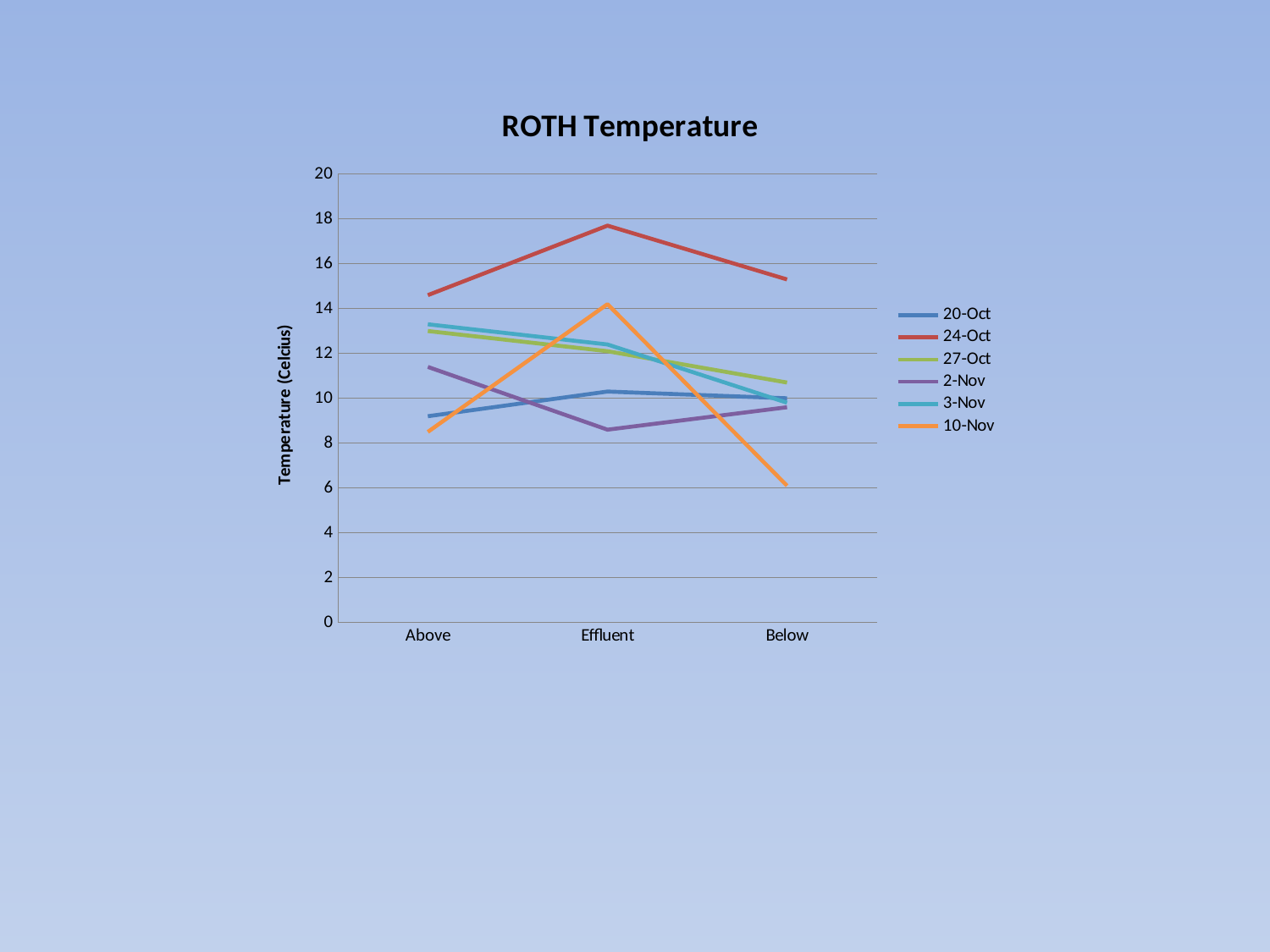
Which is larger at Above: the value for 27-Oct or the value for 20-Oct? 27-Oct Is the value for 2-Nov at Effluent greater or less than 10? less What is the title of the chart? ROTH Temperature What is the label of the vertical axis? Temperature (Celcius) Which series has the highest temperature at Effluent? 24-Oct What kind of chart is shown on the slide? line chart Does the 27-Oct series rise or fall from Above to Below? fall How many categories are shown on the x axis of the ROTH Temperature chart? 3 Is the value for 24-Oct at Effluent greater or less than 16? greater Which series has the lowest temperature at Below? 10-Nov How many series does the legend of the ROTH Temperature chart list? 6 Is the value for 10-Nov at Below greater or less than 8? less